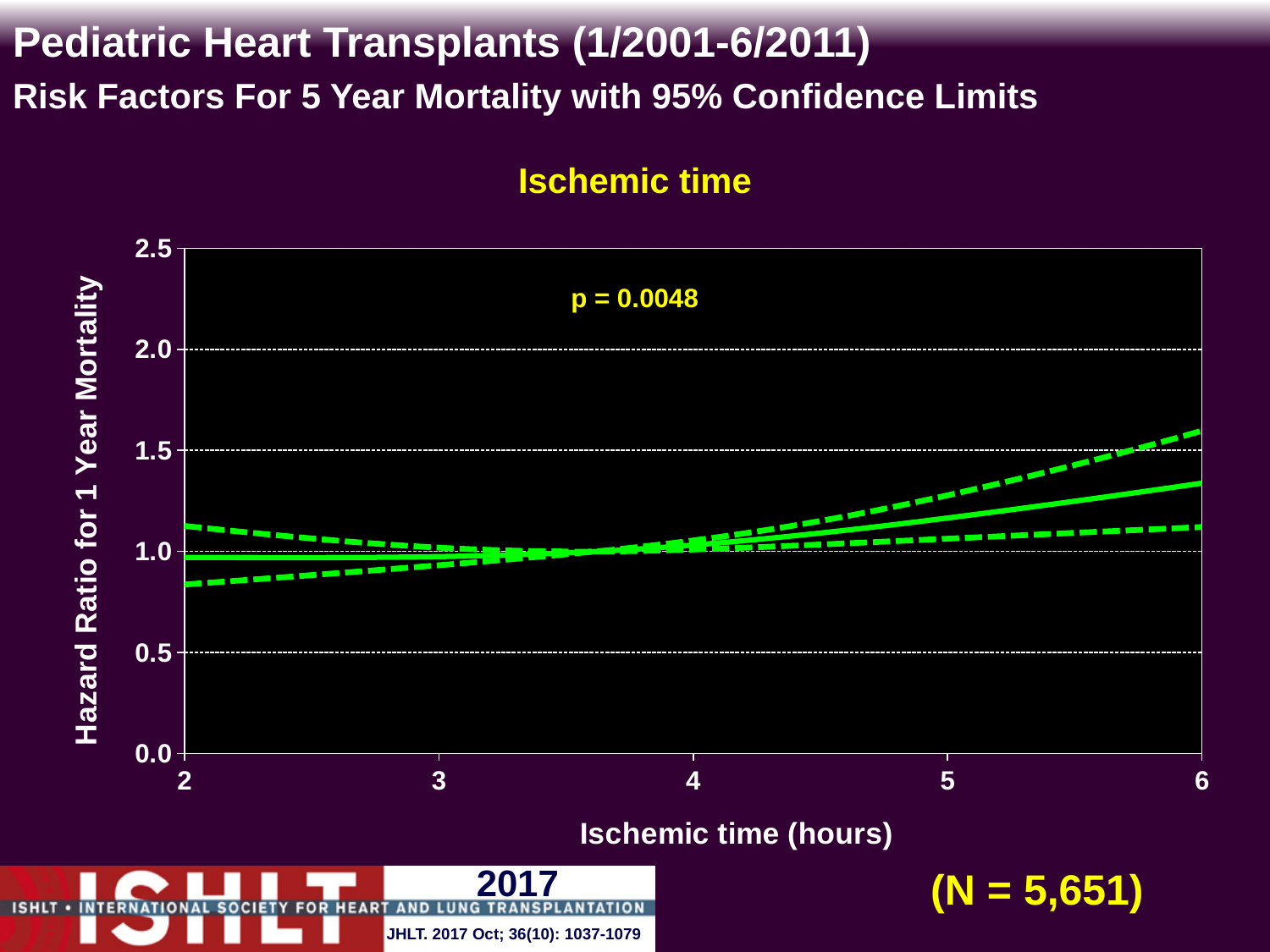
What p-value is shown on the chart? p = 0.0048 How many tick labels are shown on the x axis? 5 Is the lower 95% confidence limit (lower dashed line) at 6 hours greater or less than 1.5? less Is the hazard ratio (solid line) at 4 hours greater or less than 1.5? less How many lines are plotted on the chart? 3 What sample size (N) is shown on the slide? N = 5,651 Is the upper 95% confidence limit (upper dashed line) at 6 hours greater or less than 1.5? greater What kind of chart is shown on the slide? line chart Does the solid hazard ratio line rise or fall as ischemic time increases from 2 to 6 hours? rise